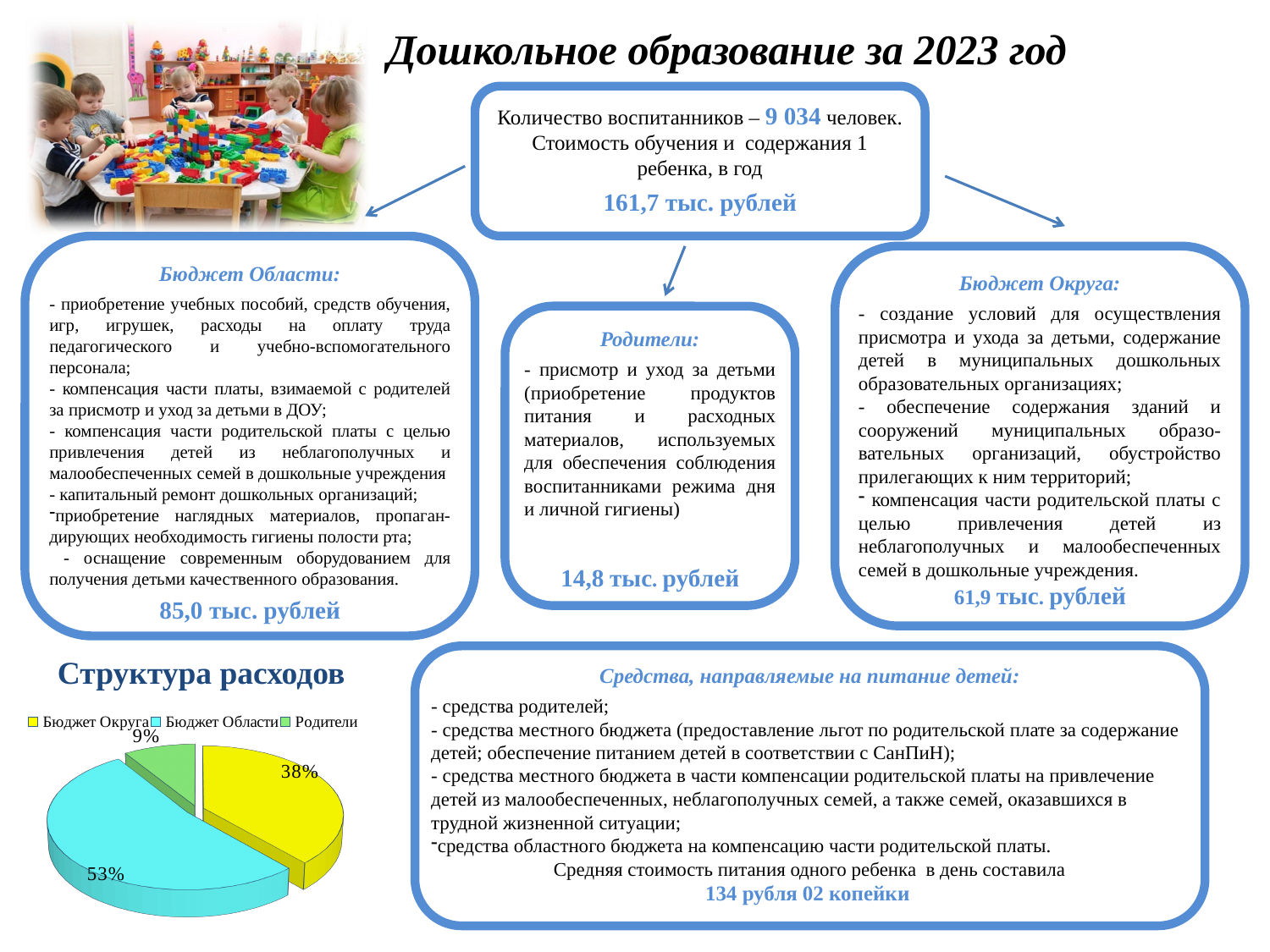
How many slices does the "Структура расходов" pie chart have? 3 Which slice of the "Структура расходов" pie chart is the largest? Бюджет Области Which slice of the "Структура расходов" pie chart is the smallest? Родители In the "Структура расходов" pie chart, which is larger: "Бюджет Округа" or "Родители"? Бюджет Округа In the "Структура расходов" pie chart, what is the difference in percentage points between "Бюджет Области" and "Бюджет Округа"? 15 In the "Структура расходов" pie chart, what share does "Бюджет Области" have? 53% In the "Структура расходов" pie chart, what is the combined share of "Бюджет Округа" and "Родители"? 47% In the "Структура расходов" pie chart, what share does "Родители" have? 9% What kind of chart is shown under the heading "Структура расходов"? pie chart In the "Структура расходов" pie chart, what share does "Бюджет Округа" have? 38% In the "Структура расходов" pie chart, what colour is the "Бюджет Округа" slice? yellow How many entries does the legend of the "Структура расходов" pie chart list? 3